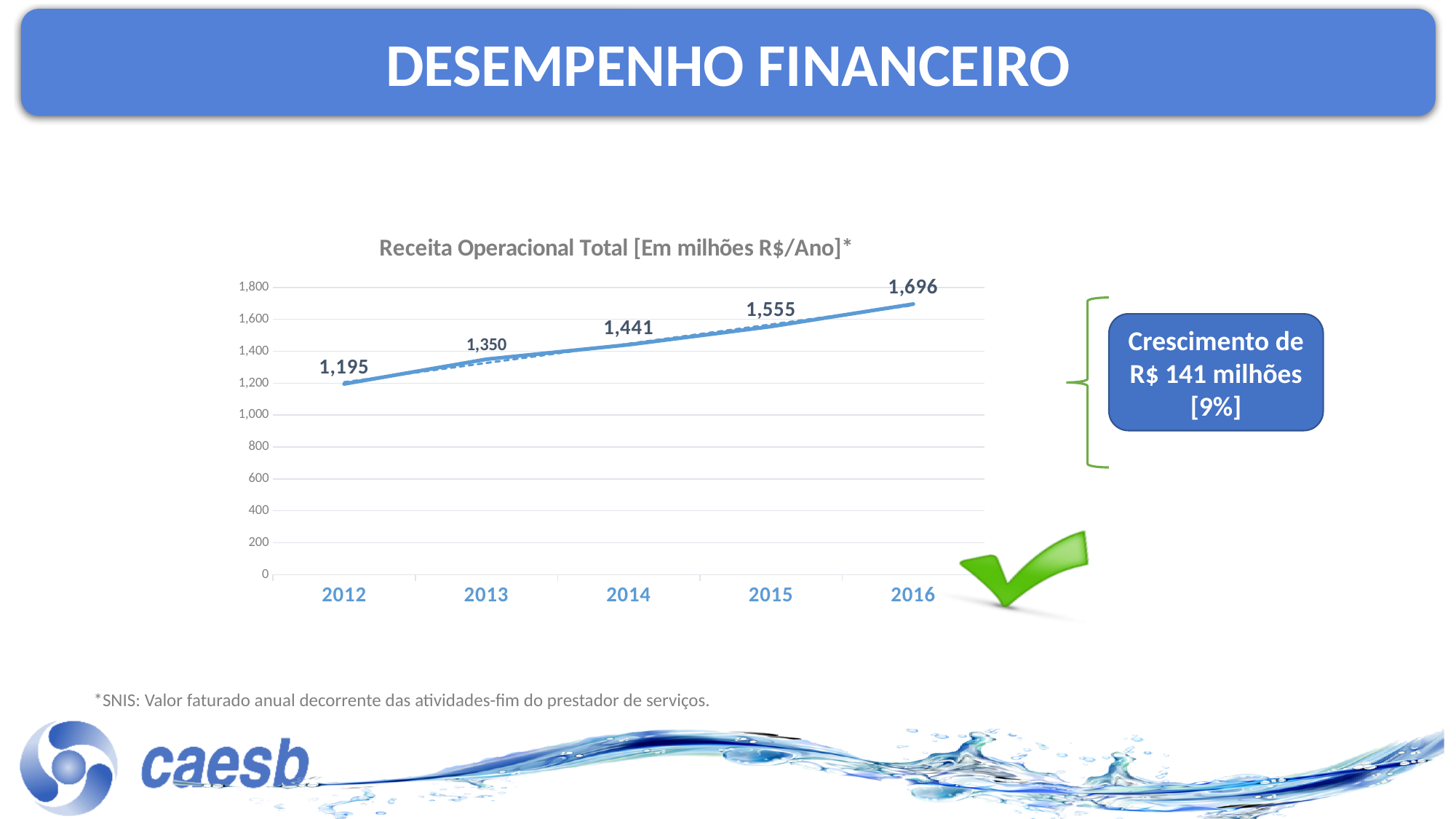
What is the difference between the values for 2016 and 2015? 141 What kind of chart is shown? line chart Which year has the lowest value? 2012 How many years are plotted on the chart? 5 What is the value for 2016? 1,696 Which is larger, the value for 2013 or the value for 2015? 2015 Do the values rise or fall from 2012 to 2016? rise What is the difference between the values for 2013 and 2012? 155 Which year has the highest value? 2016 What is the value for 2012? 1,195 What is the value for 2014? 1,441 Is the value for 2014 greater or less than 1,400? greater